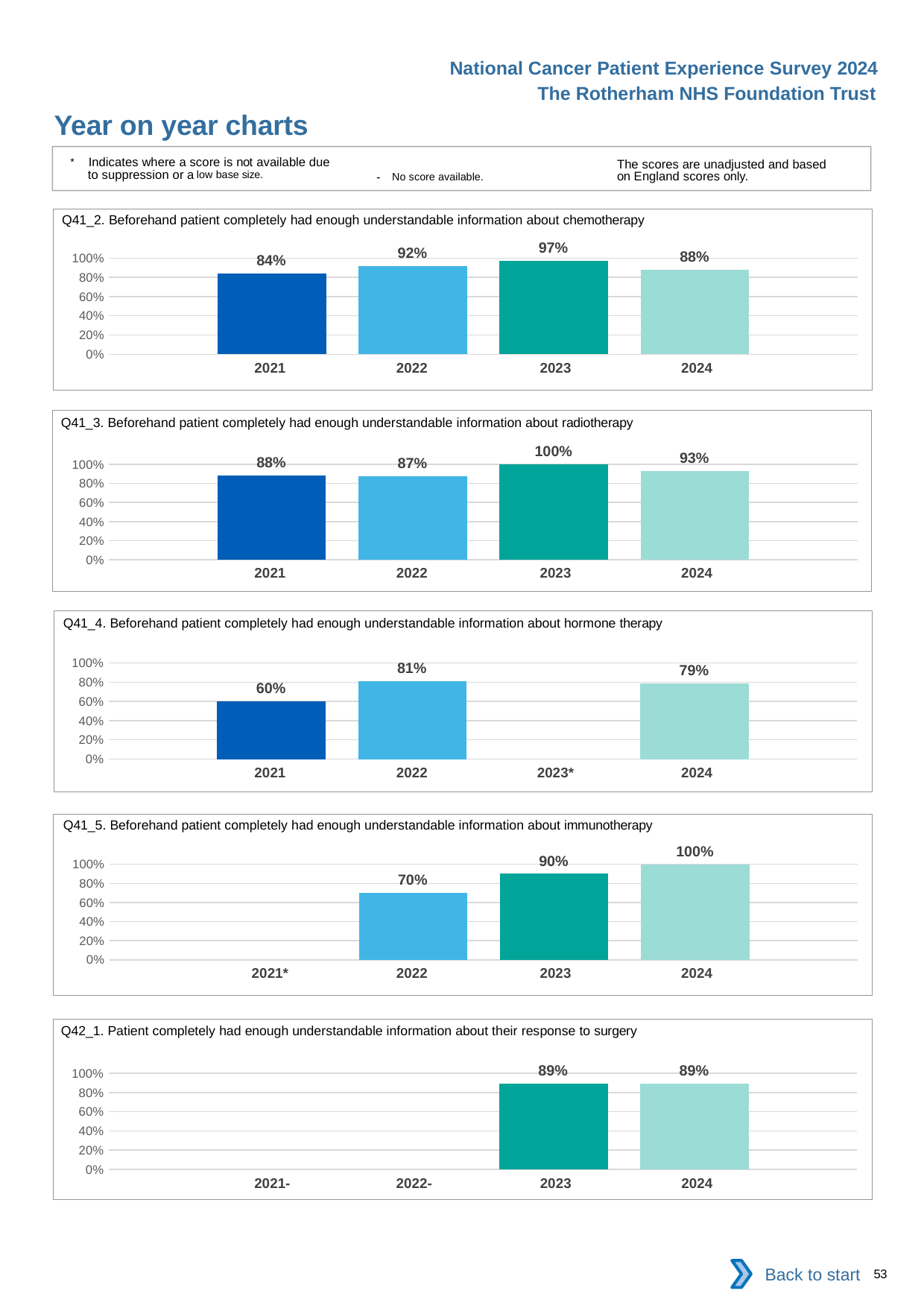
In the Q41_3 radiotherapy chart, what is the difference between the 2023 and 2022 values? 13% In the Q42_1 surgery chart, how many bars are plotted? 2 In the Q41_2 chemotherapy chart, what is the value for 2023? 97% In the Q42_1 surgery chart, what is the value for 2024? 89% In the Q41_3 radiotherapy chart, what is the value for 2024? 93% In the Q41_4 hormone therapy chart, which year has the highest value? 2022 What type of chart is the Q41_2 chemotherapy chart? bar chart In the Q41_5 immunotherapy chart, do the values rise or fall from 2022 to 2024? rise In the Q41_4 hormone therapy chart, which year has no bar shown? 2023* In the Q41_5 immunotherapy chart, what is the difference between the 2024 and 2022 values? 30% In the Q41_4 hormone therapy chart, what is the value for 2021? 60% In the Q41_2 chemotherapy chart, which year has the lowest value? 2021